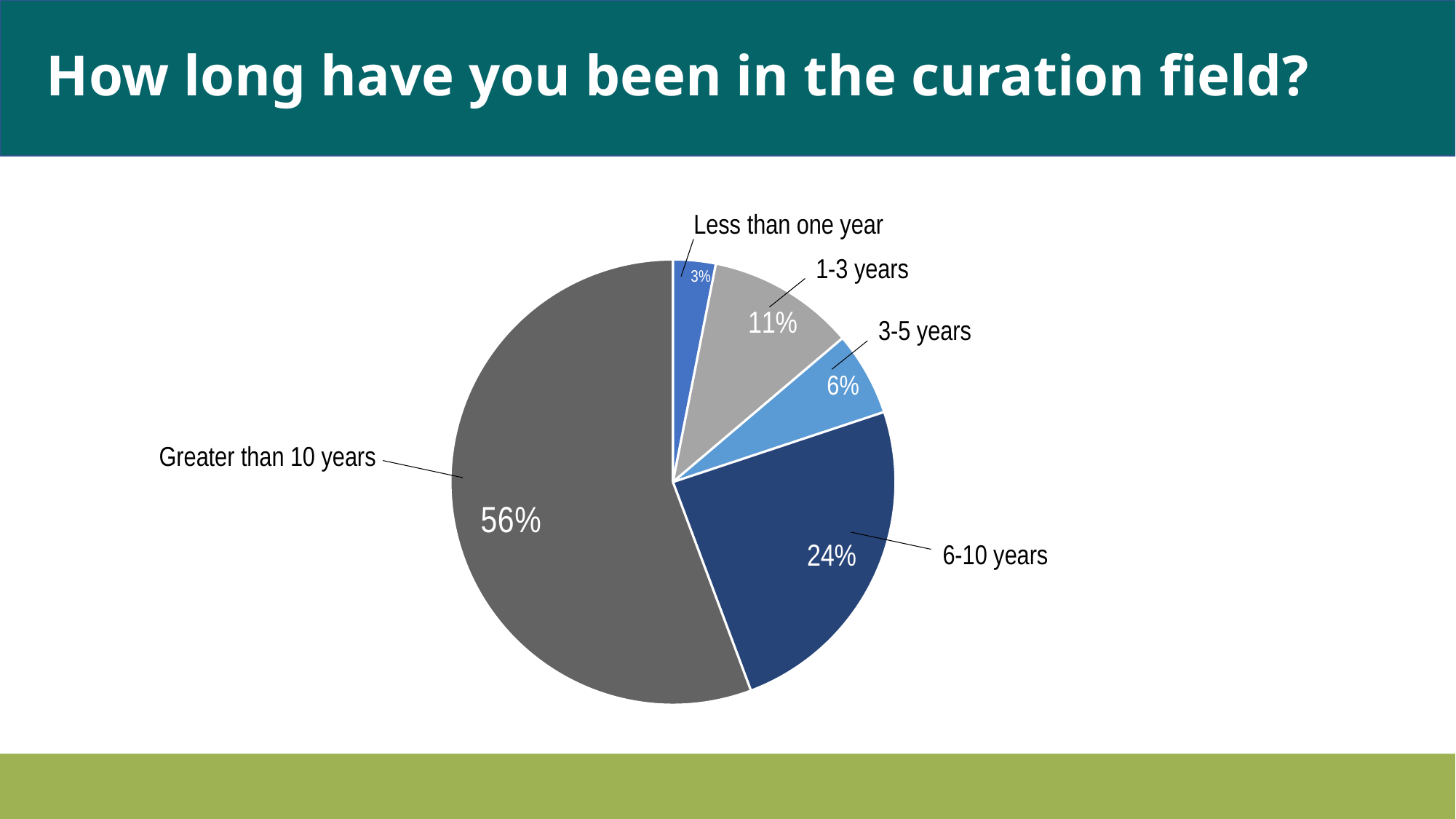
What percentage of respondents have been in the curation field for 1-3 years? 11% Which is larger: the share for 1-3 years or the share for 3-5 years? 1-3 years What percentage of respondents have been in the curation field for less than one year? 3% What kind of chart is shown on the slide? Pie chart Which category has the smallest slice of the pie? Less than one year What is the title of the slide? How long have you been in the curation field? What percentage of respondents have been in the curation field for 3-5 years? 6% Which category has the largest slice of the pie? Greater than 10 years What is the difference in percentage points between the 'Greater than 10 years' slice and the '6-10 years' slice? 32 What percentage of respondents have been in the curation field for 6-10 years? 24% What share of respondents have been in the curation field for greater than 10 years? 56% How many categories are shown in the pie chart? 5